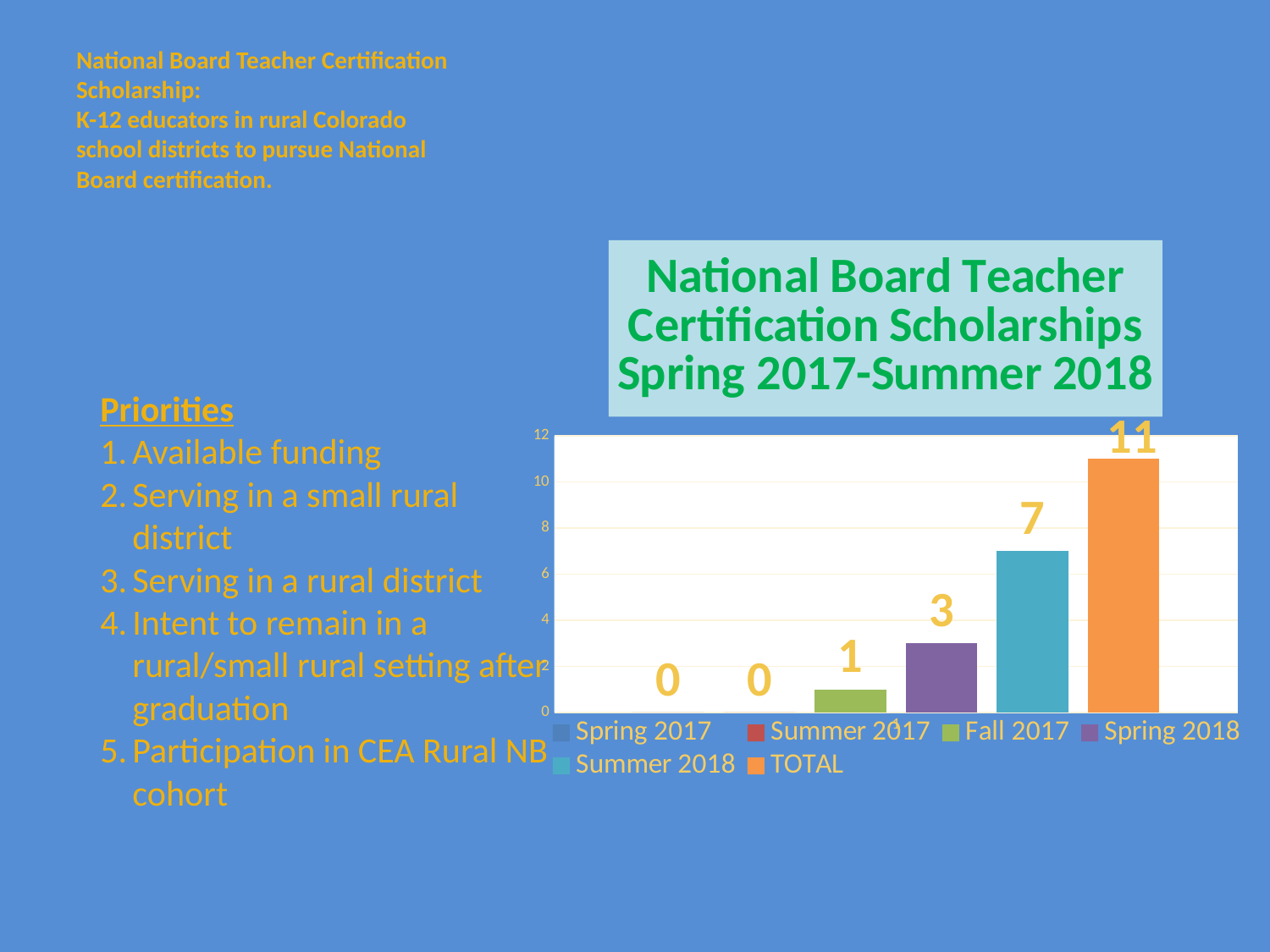
Is the value for TOTAL greater or less than 10? greater What is the value for Spring 2017? 0 What is the value for Spring 2018? 3 Which is larger, the value for Fall 2017 or the value for Spring 2018? Spring 2018 How many entries does the chart legend list? 6 What type of chart is shown on the slide? bar chart What is the title of the chart? National Board Teacher Certification Scholarships Spring 2017-Summer 2018 What is the value for Fall 2017? 1 What is the value for Summer 2018? 7 Which legend entry has the highest value? TOTAL What is the difference between the Summer 2018 value and the Spring 2018 value? 4 What is the value for TOTAL? 11